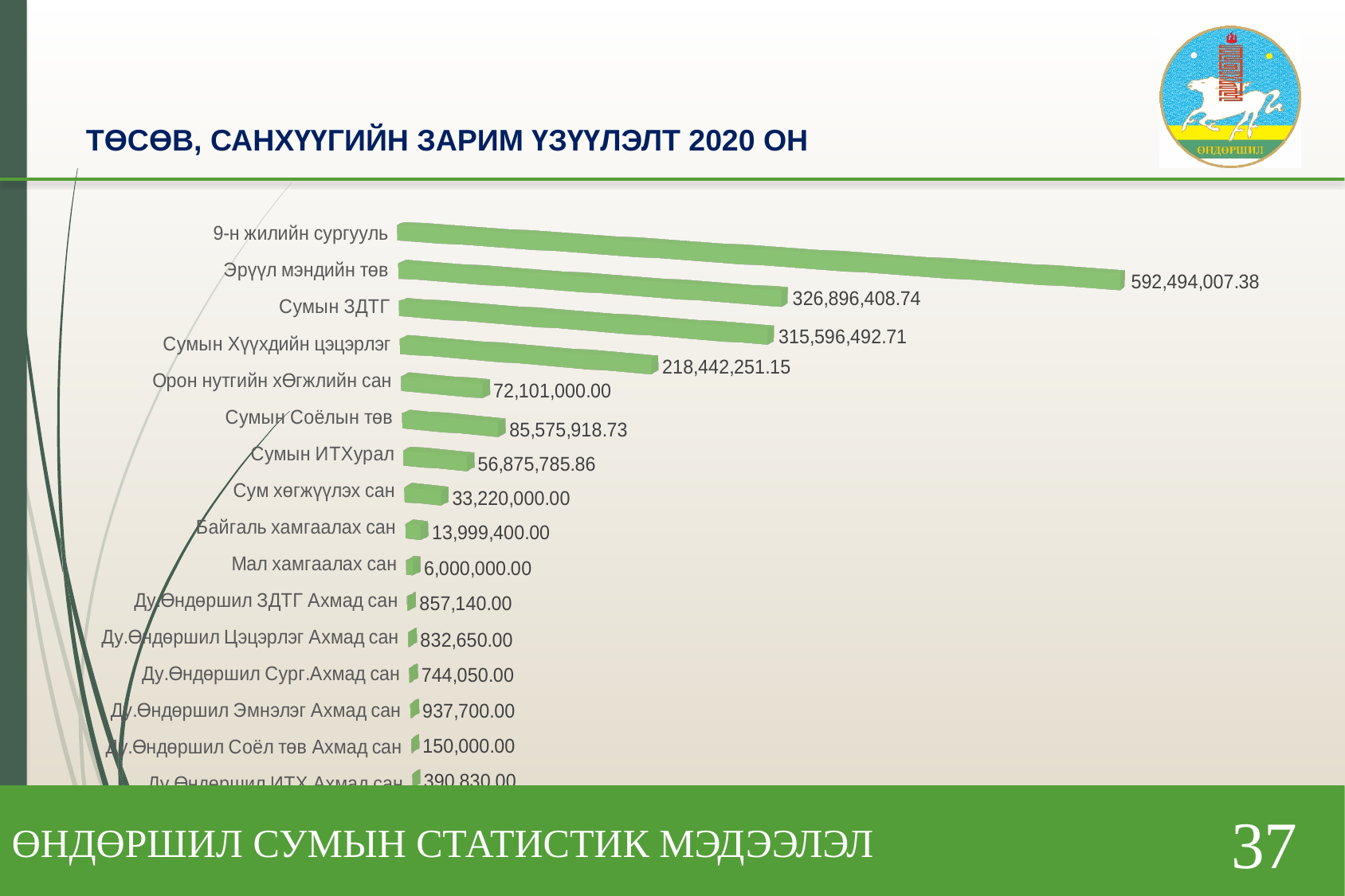
Which category has the highest value? 9-н жилийн сургууль Which category has the lowest value? Ду.Өндөршил Соёл төв Ахмад сан What is the value for Сумын Хүүхдийн цэцэрлэг? 218,442,251.15 What is the title of the slide? ТӨСӨВ, САНХҮҮГИЙН ЗАРИМ ҮЗҮҮЛЭЛТ 2020 ОН What is the value for Ду.Өндөршил Эмнэлэг Ахмад сан? 937,700.00 What kind of chart is shown on the slide? Bar chart What is the value for Орон нутгийн хөгжлийн сан? 72,101,000.00 Which is larger, the value for Сумын Соёлын төв or Орон нутгийн хөгжлийн сан? Сумын Соёлын төв What is the difference between the values for Эрүүл мэндийн төв and Сумын ЗДТГ? 11,299,916.03 What is the value for Мал хамгаалах сан? 6,000,000.00 What is the value for Эрүүл мэндийн төв? 326,896,408.74 How many categories are shown in the chart? 16